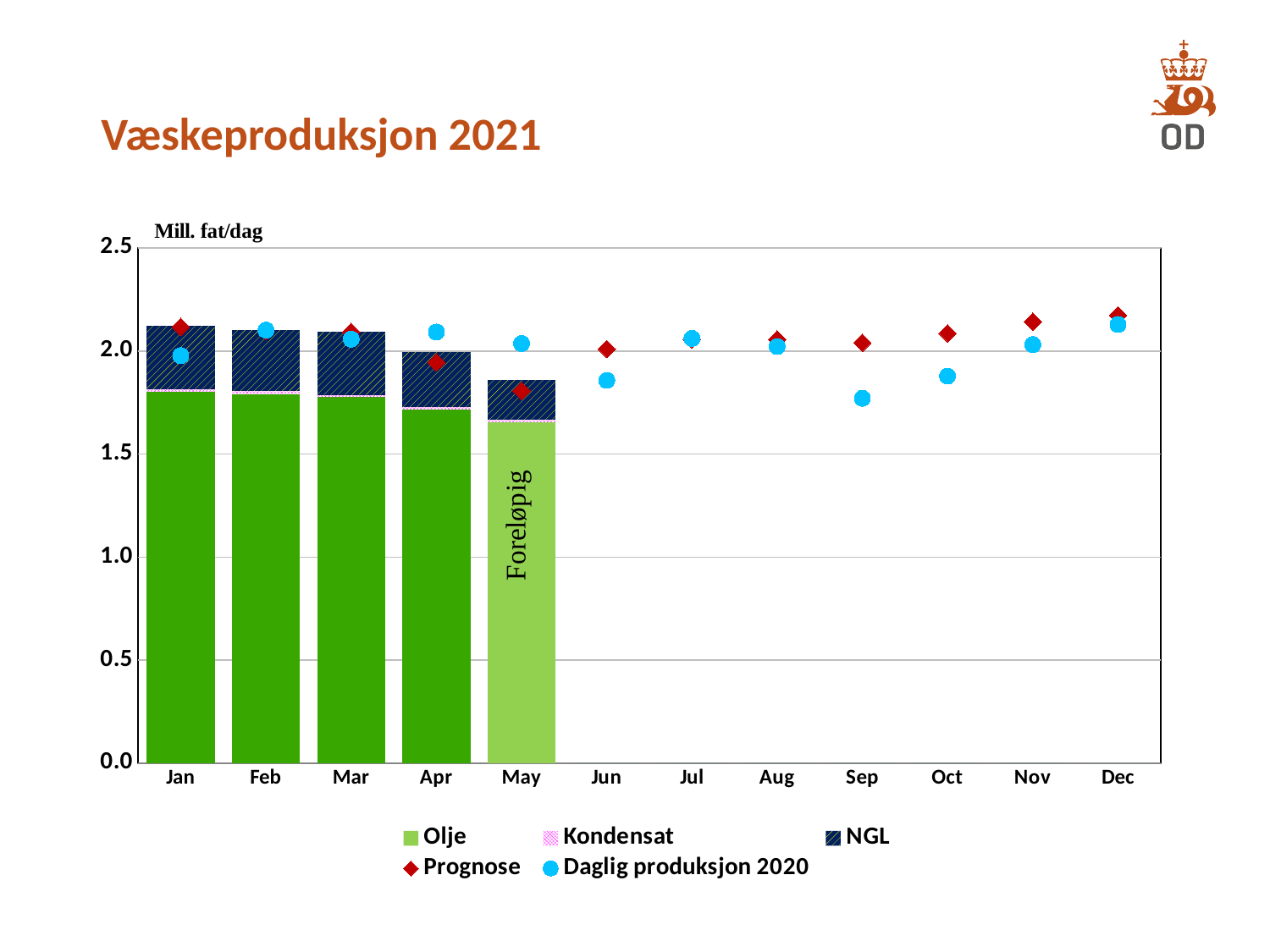
Which month has the lowest total stacked bar? May What is the title of the chart? Væskeproduksjon 2021 Is the total stacked bar for Jan greater or less than 2.0? greater Is the total stacked bar for May greater or less than 2.0? less Is the Daglig produksjon 2020 value for Sep greater or less than 2.0? less What kind of chart is shown on the slide? Stacked bar chart with overlaid markers For how many months are stacked bars plotted? 5 How many series does the legend list? 5 Do the total stacked bars rise or fall from Jan to May? fall How many months are shown on the x axis? 12 What unit label is shown above the y axis? Mill. fat/dag In Sep, which is larger: the Prognose value or the Daglig produksjon 2020 value? Prognose